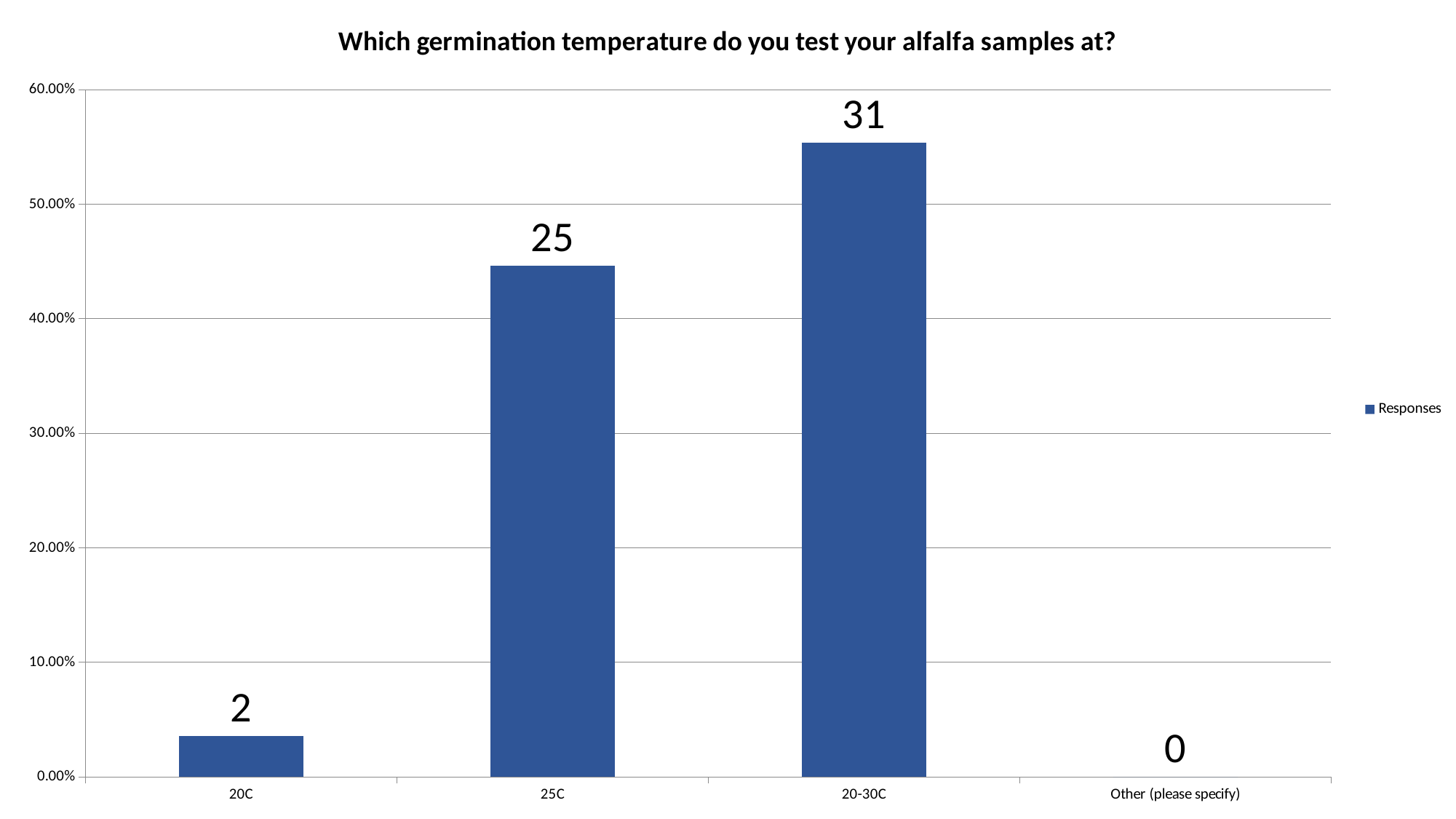
Is the bar for 25C greater or less than 40.00% on the axis? greater What data label is shown above the bar for 20-30C? 31 Which category has the lowest value? Other (please specify) Is the bar for 20C greater or less than 10.00% on the axis? less Which category has the highest bar? 20-30C Which is larger, the value for 25C or the value for 20C? 25C What kind of chart is this? Bar chart What data label is shown for the category Other (please specify)? 0 How many categories are shown on the x axis? 4 What data label is shown above the bar for 20C? 2 What data label is shown above the bar for 25C? 25 What is the difference between the data labels for 20-30C and 25C? 6